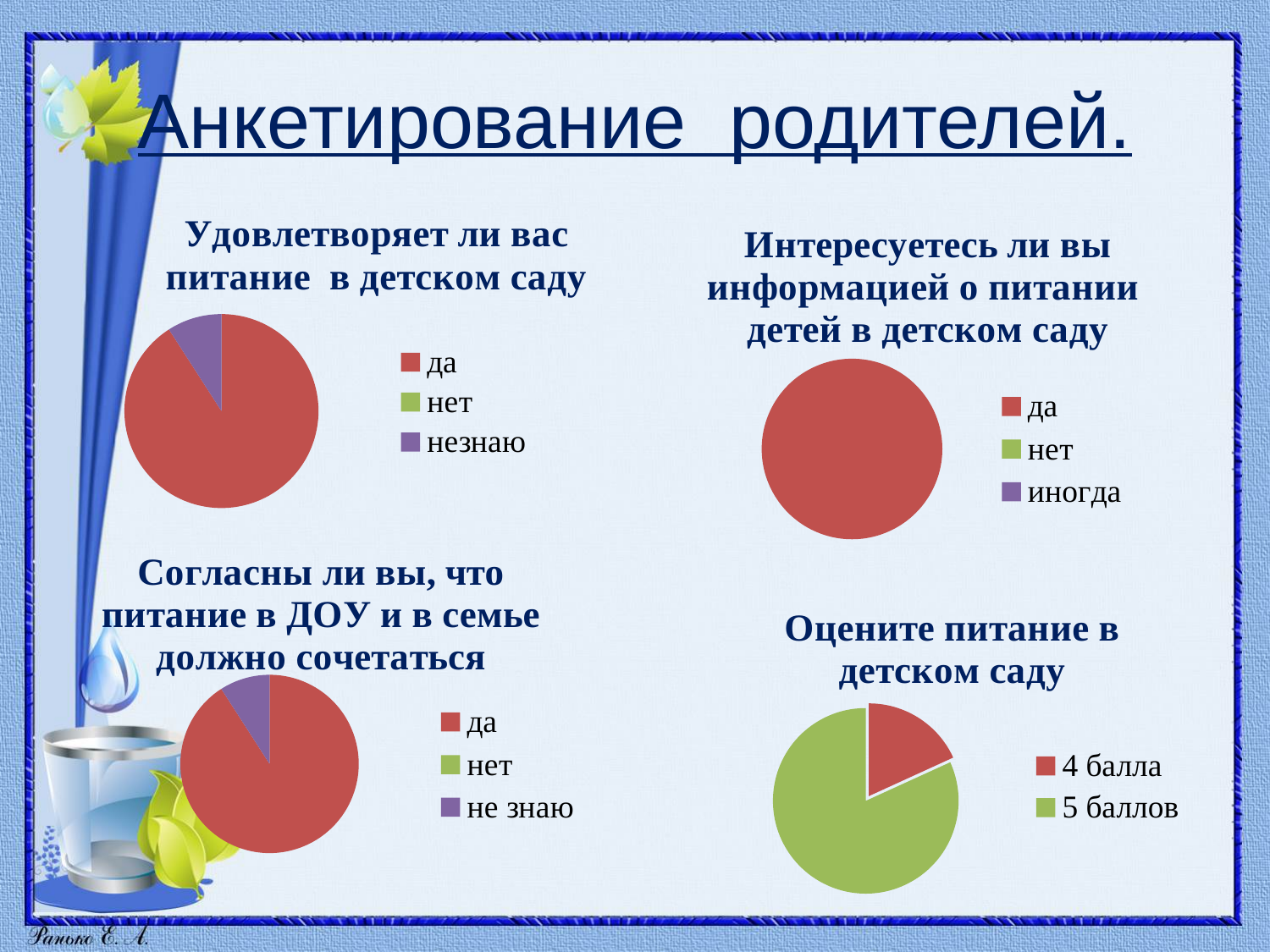
In the chart "Интересуетесь ли вы информацией о питании детей в детском саду", which answer has the largest slice? да How many pie charts are shown on the slide? 4 How many entries does the legend list for the chart "Интересуетесь ли вы информацией о питании детей в детском саду"? 3 In the chart "Согласны ли вы, что питание в ДОУ и в семье должно сочетаться", which answer has the largest slice? да In the chart "Оцените питание в детском саду", what colour represents "5 баллов"? green In the chart "Оцените питание в детском саду", which rating has the largest slice? 5 баллов How many entries does the legend list for the chart "Удовлетворяет ли вас питание в детском саду"? 3 In the chart "Оцените питание в детском саду", which rating has the smallest slice? 4 балла What kind of chart is used for "Удовлетворяет ли вас питание в детском саду"? pie chart In the chart "Согласны ли вы, что питание в ДОУ и в семье должно сочетаться", which is larger: the slice for "да" or the slice for "не знаю"? да How many entries does the legend list for the chart "Оцените питание в детском саду"? 2